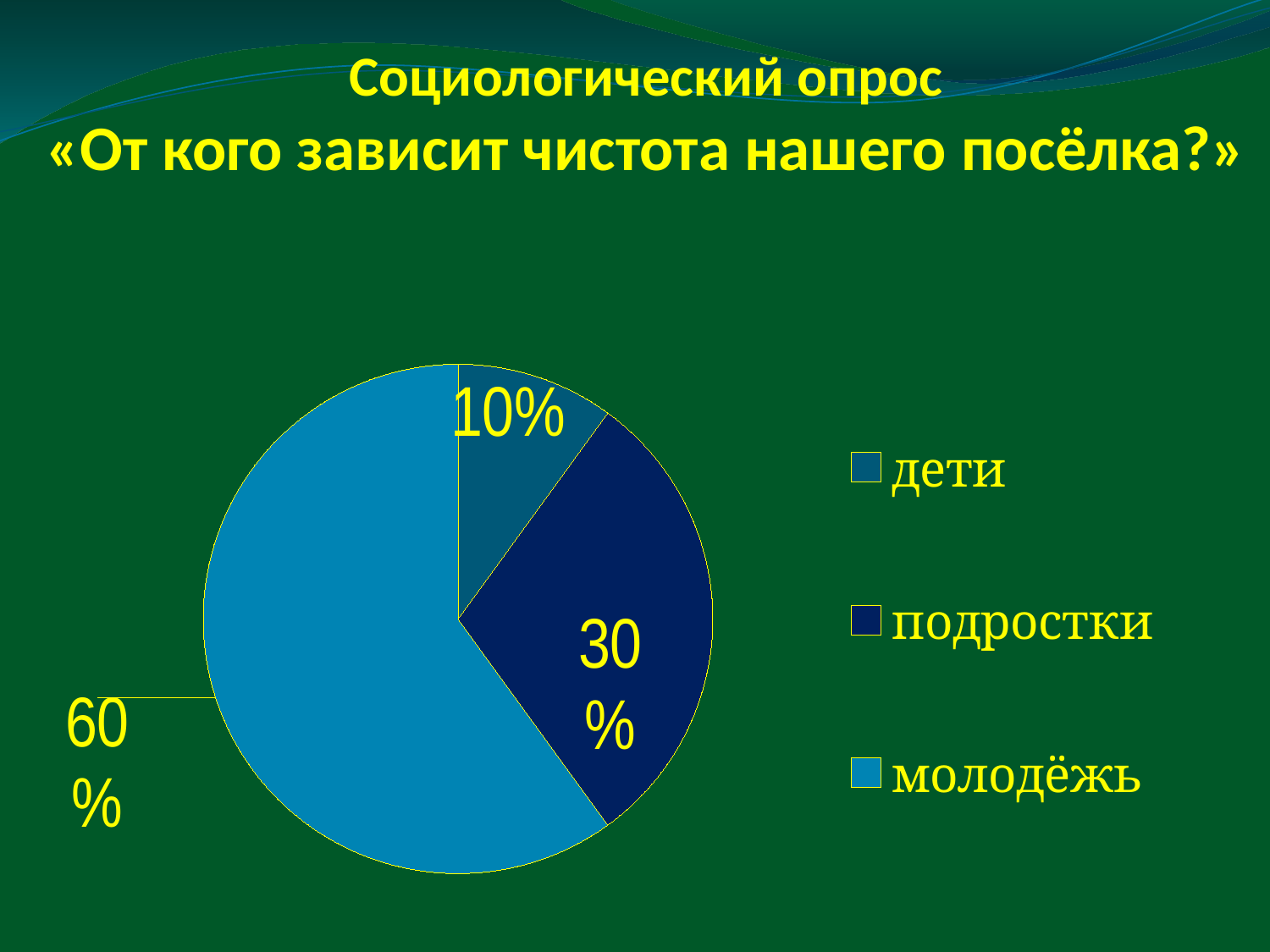
Which is larger, the share for подростки or the share for дети? подростки What share of the pie does подростки have? 30% What kind of chart is shown on the slide? pie chart What share of the pie does молодёжь have? 60% What share of the pie does дети have? 10% How many categories does the pie chart have? 3 Which legend entry is shown in the darkest blue colour? подростки Which category has the smallest slice of the pie? дети How many entries does the legend list? 3 What is the difference between the shares for молодёжь and подростки? 30% Which category has the largest slice of the pie? молодёжь What is the difference between the shares for подростки and дети? 20%